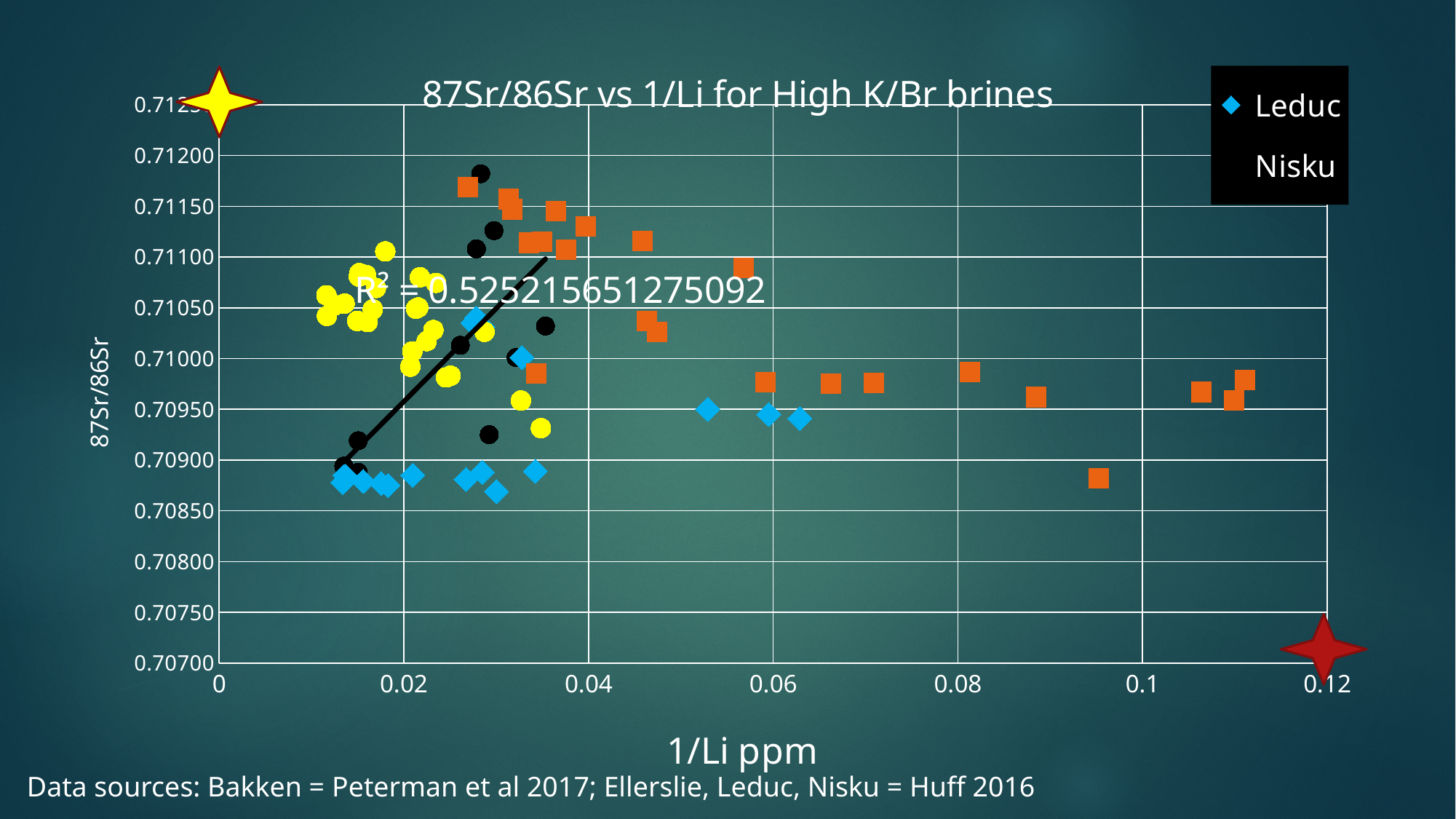
What is the label of the x axis? 1/Li ppm What is the lowest value shown on the y axis? 0.70700 What is the R² value printed on the chart? 0.525215651275092 How many series does the chart legend list? 2 What kind of chart is shown on the slide? scatter chart What is the highest value shown on the x axis? 0.12 What is the title of the chart? 87Sr/86Sr vs 1/Li for High K/Br brines Are the 87Sr/86Sr values of the Leduc points near 1/Li = 0.015 greater or less than 0.70900? less